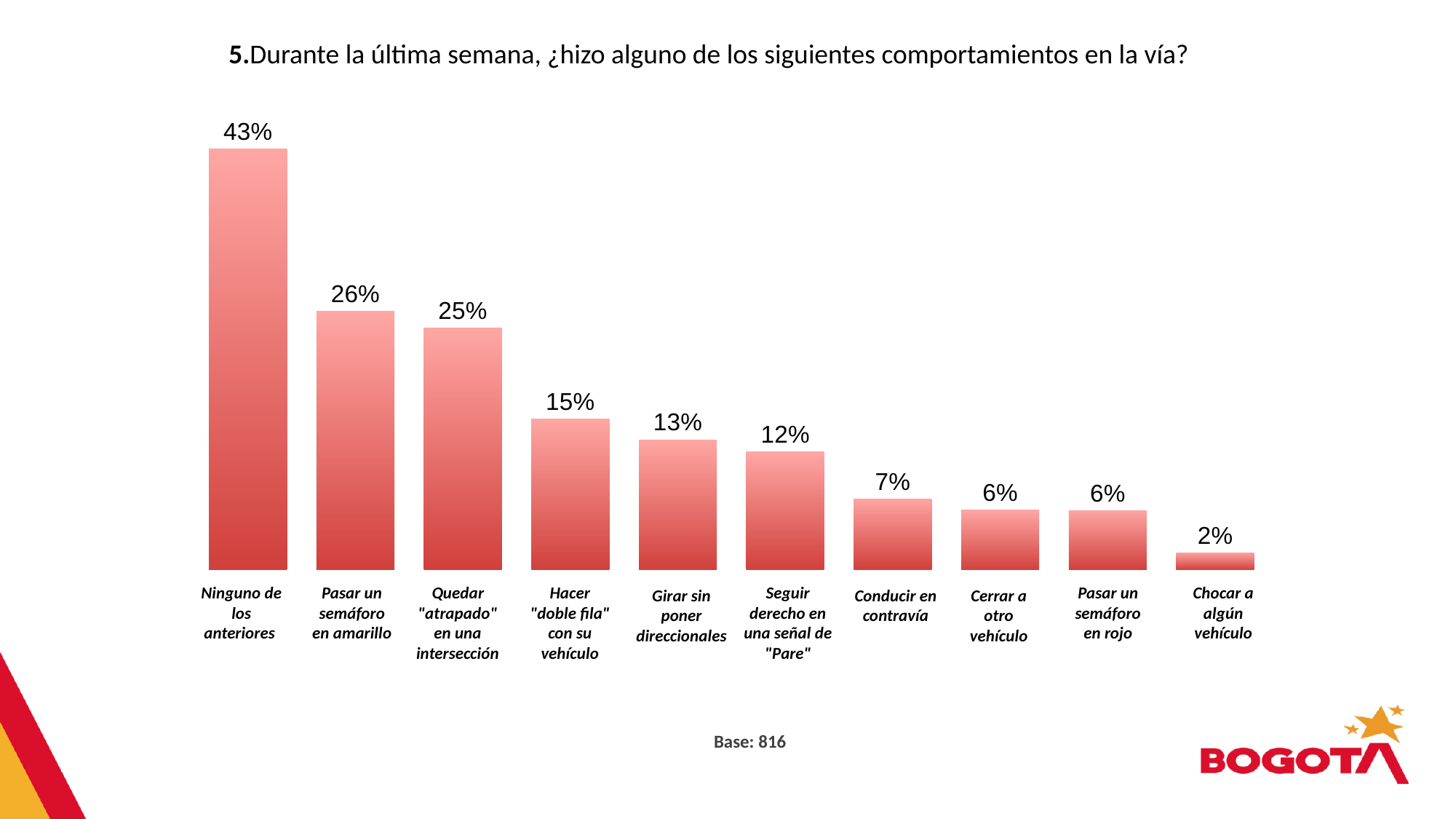
What percentage is shown for "Ninguno de los anteriores"? 43% How many categories are shown in the chart? 10 What is the value for "Chocar a algún vehículo"? 2% What is the value for "Pasar un semáforo en amarillo"? 26% What is the difference between "Pasar un semáforo en amarillo" and "Quedar "atrapado" en una intersección"? 1% What is the difference between "Hacer "doble fila" con su vehículo" and "Conducir en contravía"? 8% What is the base (number of respondents) noted below the chart? 816 What percentage is shown for "Girar sin poner direccionales"? 13% What kind of chart is shown on the slide? Bar chart Which category has the highest value? Ninguno de los anteriores Which category has the lowest value? Chocar a algún vehículo Which is larger, the value for "Seguir derecho en una señal de "Pare"" or the value for "Conducir en contravía"? Seguir derecho en una señal de "Pare"